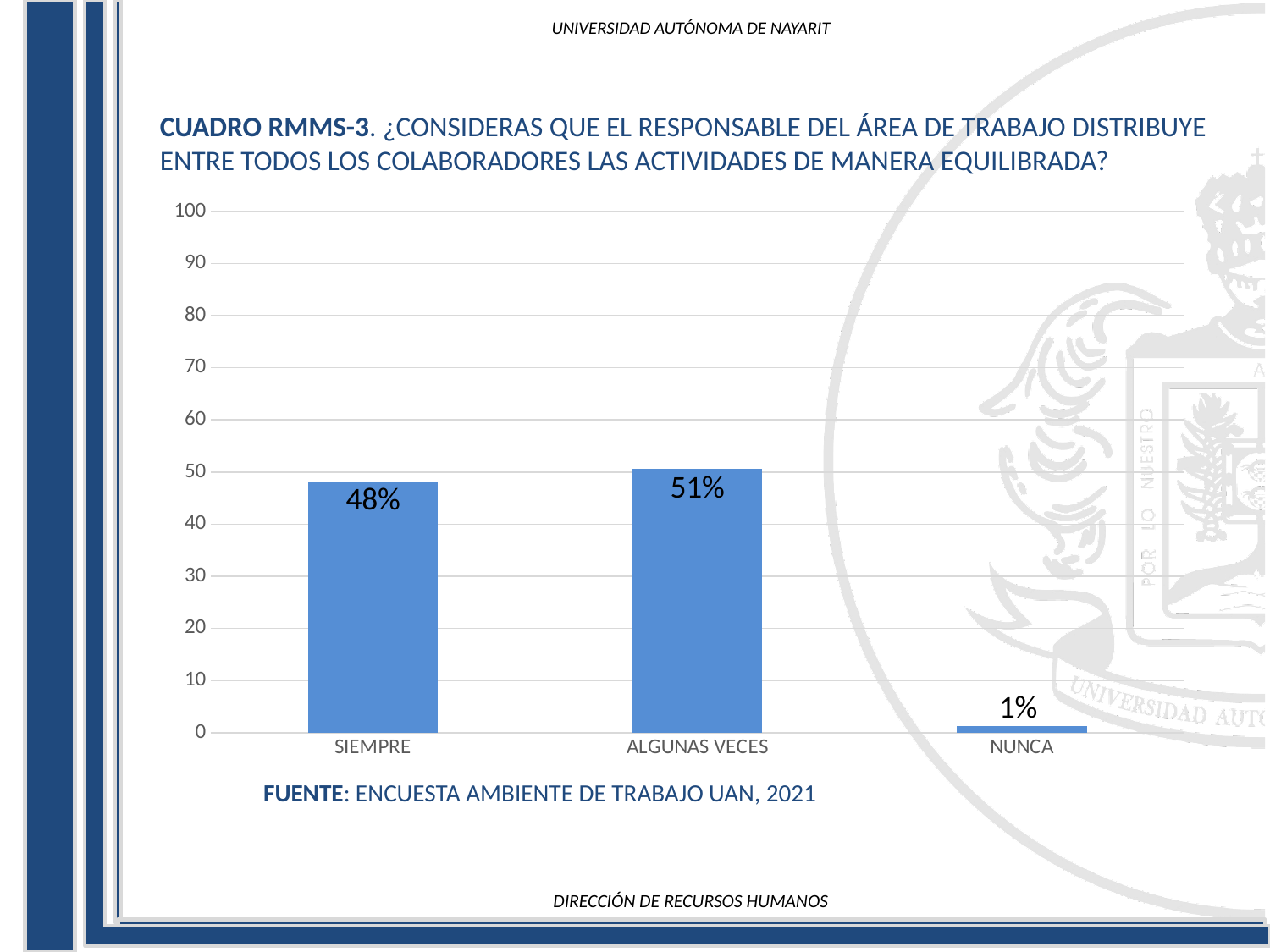
What is the difference between the values for ALGUNAS VECES and SIEMPRE? 3% What kind of chart is shown on the slide? bar chart What is the value for NUNCA? 1% Which category has the lowest value? NUNCA What is the value for SIEMPRE? 48% What is the value for ALGUNAS VECES? 51% What is the difference between the values for SIEMPRE and NUNCA? 47% Which category has the highest value? ALGUNAS VECES Is the value for SIEMPRE greater or less than 50? less How many categories are shown on the chart? 3 What source is cited below the chart? ENCUESTA AMBIENTE DE TRABAJO UAN, 2021 Which is larger, the value for SIEMPRE or the value for NUNCA? SIEMPRE